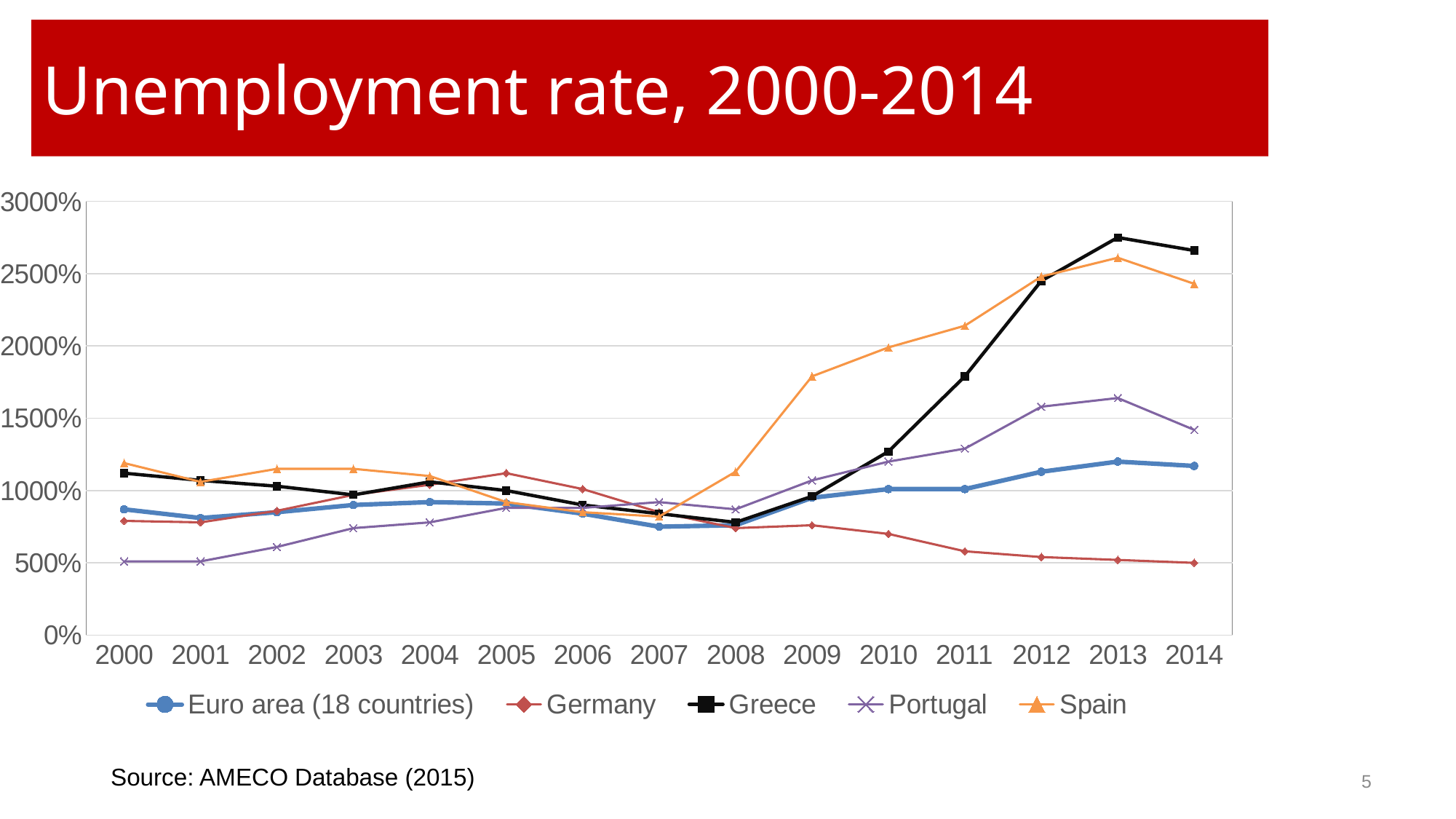
In which year does Greece reach its highest value? 2013 Which is larger in 2012, the value for Spain or the value for Portugal? Spain How many years are plotted along the x axis? 15 Is the value for Spain in 2009 greater or less than 1500%? greater Does the value for Germany rise or fall from 2009 to 2014? fall How many series does the legend list? 5 What kind of chart is shown on the slide? line chart Is the value for Germany in 2014 greater or less than 1000%? less Is the value for Greece in 2013 greater or less than 2500%? greater What is the title of the slide? Unemployment rate, 2000-2014 Which series has the highest value in 2013? Greece Which series has the lowest value in 2014? Germany